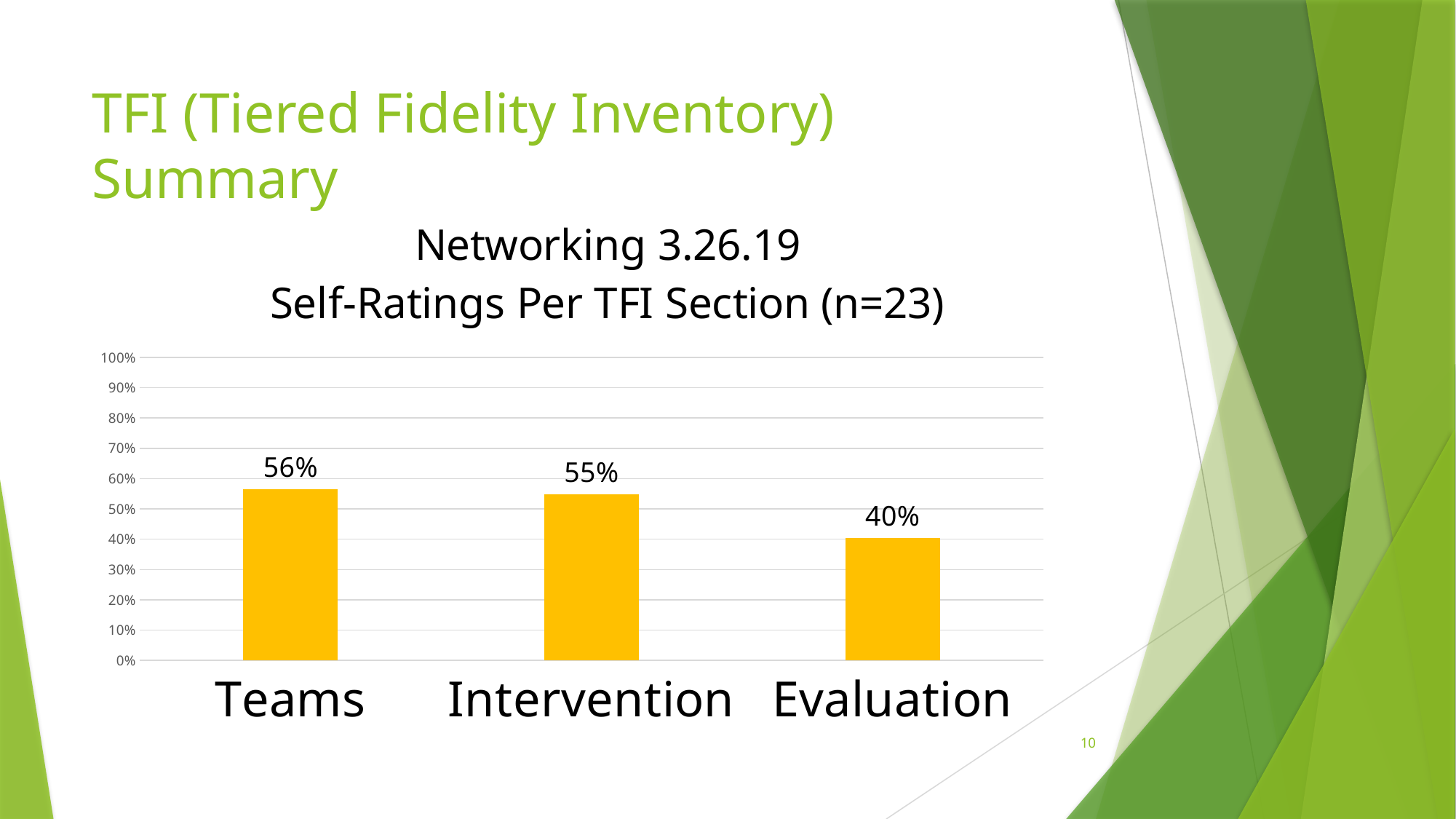
Which TFI section has the highest self-rating? Teams What is the self-rating value for Evaluation? 40% What is the self-rating value for Intervention? 55% Which TFI section has the lowest self-rating? Evaluation What is the difference between the Intervention and Evaluation self-ratings? 15% What kind of chart is shown on the slide? bar chart How many TFI sections are shown in the chart? 3 Which is larger, the self-rating for Intervention or for Evaluation? Intervention What is the self-rating value for Teams? 56% What is the difference between the Teams and Evaluation self-ratings? 16% Is the value for Evaluation greater or less than 50%? less What is the sample size (n) stated in the chart title? 23